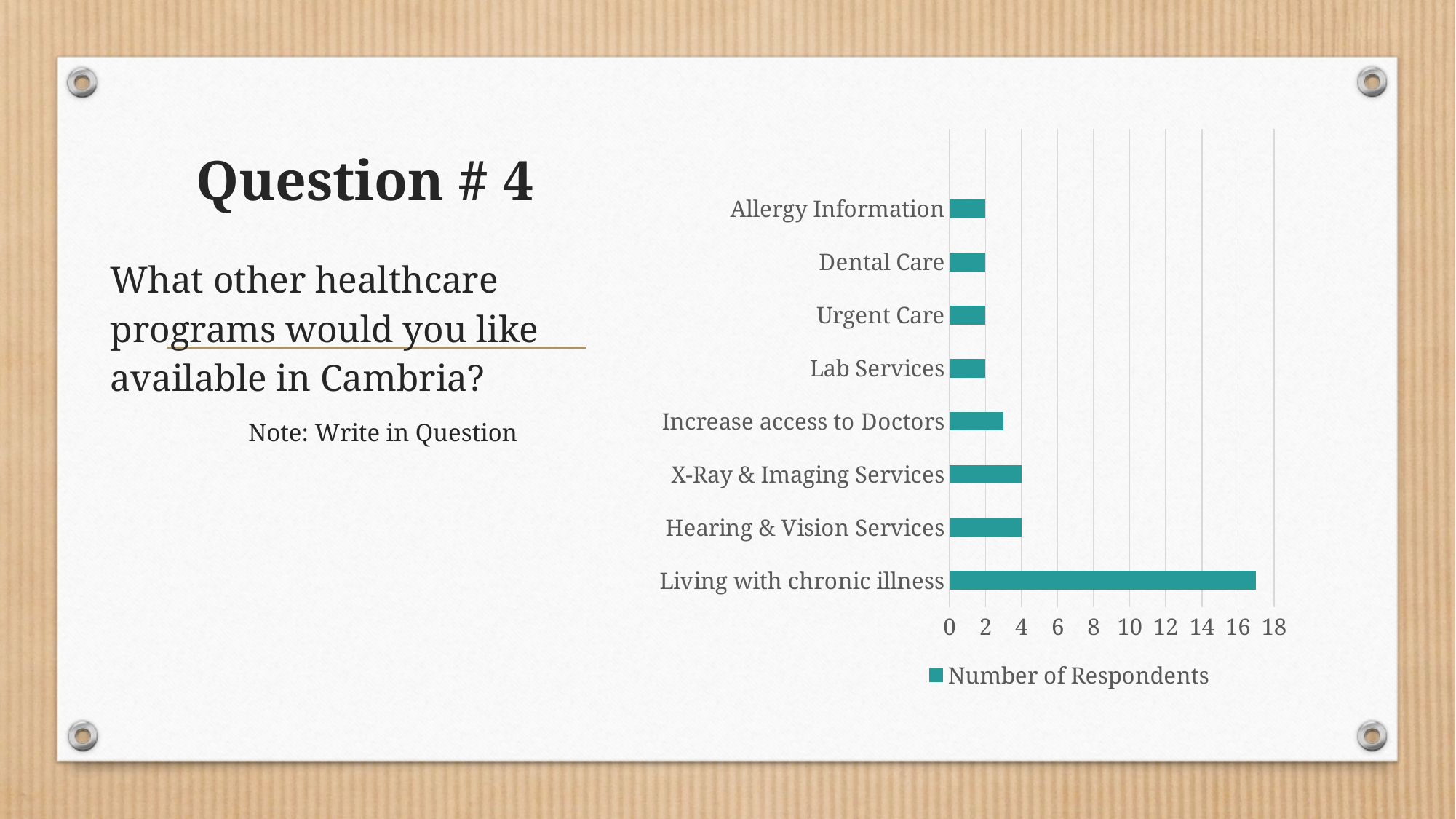
Is the value for Living with chronic illness greater or less than 16? greater What is the number of respondents for Dental Care? 2 Which category has the highest number of respondents? Living with chronic illness What is the number of respondents for Hearing & Vision Services? 4 Which has more respondents, Living with chronic illness or Hearing & Vision Services? Living with chronic illness What kind of chart is shown on the slide? bar chart What is the difference in respondents between X-Ray & Imaging Services and Lab Services? 2 What is the number of respondents for X-Ray & Imaging Services? 4 What is the name of the series shown in the chart legend? Number of Respondents How many categories are plotted in the chart? 8 How many series does the chart legend list? 1 Is the value for Increase access to Doctors greater or less than 4? less